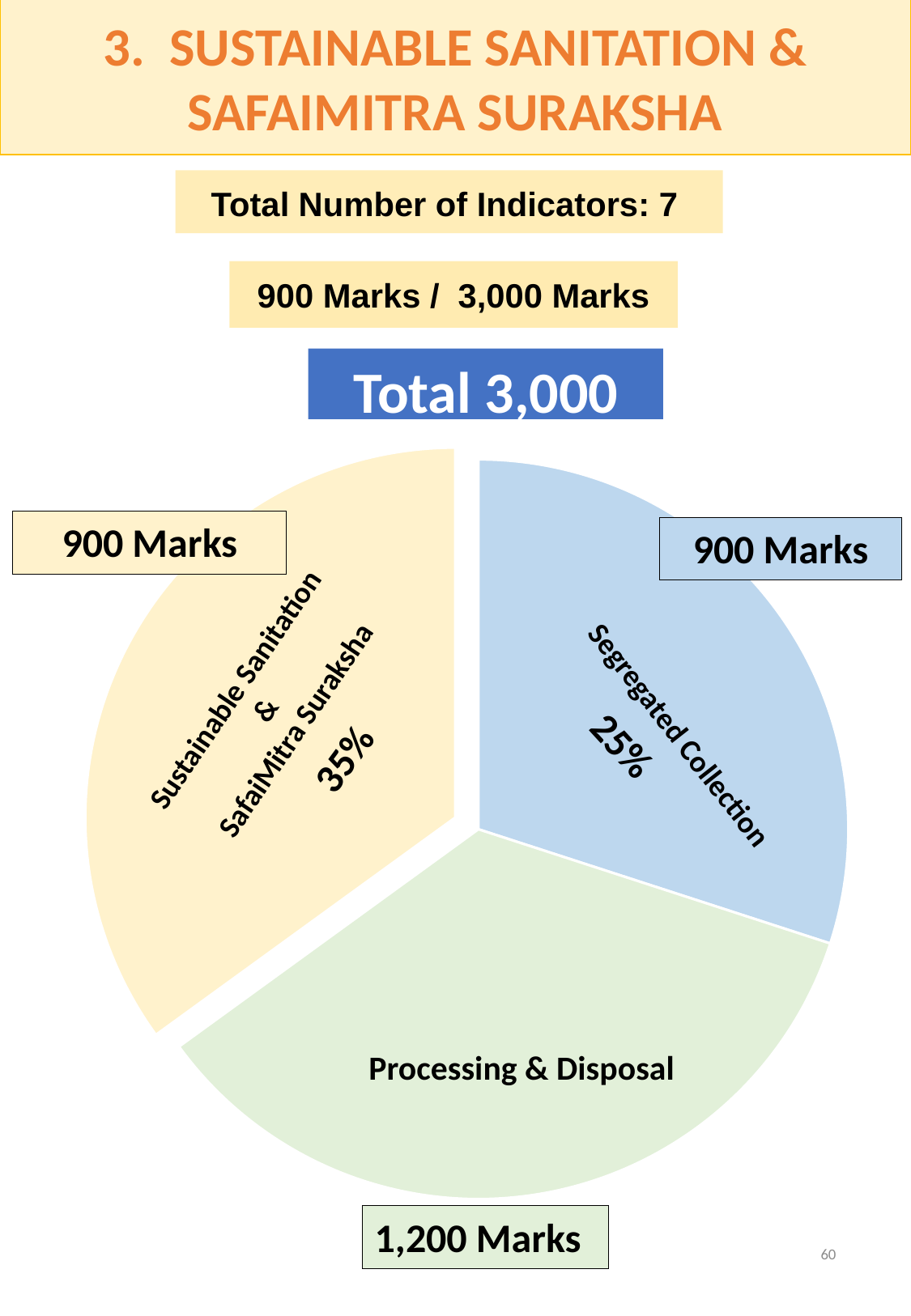
What colour is the Processing & Disposal slice? green Which slice of the pie chart has the most marks? Processing & Disposal What kind of chart is shown on the slide? pie chart What percentage is printed on the Sustainable Sanitation & SafaiMitra Suraksha slice? 35% How many marks are shown for the Processing & Disposal slice? 1,200 Marks Which has more marks, Processing & Disposal or Segregated Collection? Processing & Disposal What total is shown above the pie chart? 3,000 What is the difference in marks between Processing & Disposal and Segregated Collection? 300 Marks How many marks are shown for the Segregated Collection slice? 900 Marks How many slices does the pie chart have? 3 What percentage is printed on the Segregated Collection slice? 25% How many marks are shown for the Sustainable Sanitation & SafaiMitra Suraksha slice? 900 Marks